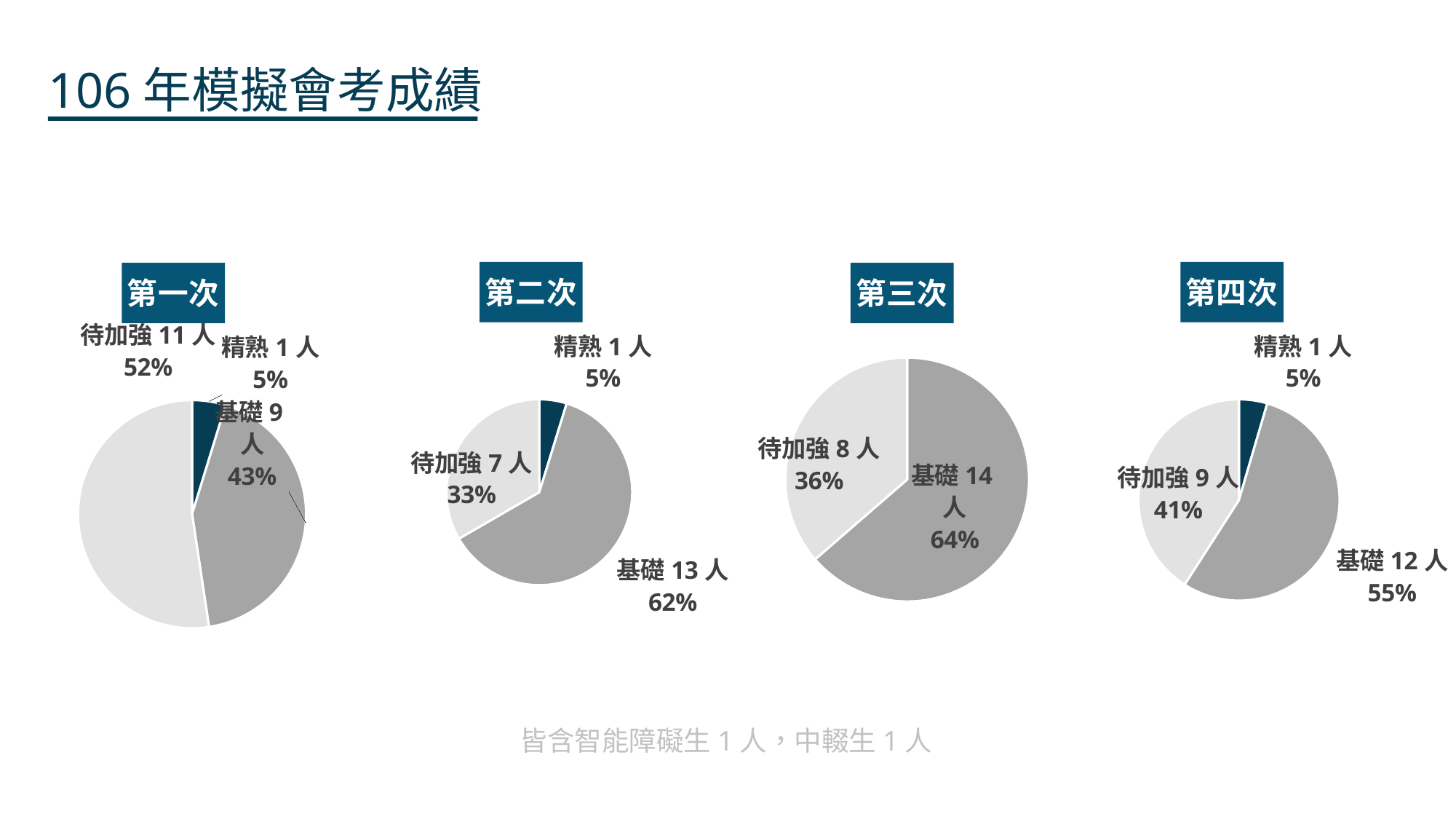
In the 第四次 pie chart, which is larger, 待加強 or 基礎? 基礎 In the 第二次 pie chart, what percentage is shown for 基礎? 62% In the 第三次 pie chart, what percentage is shown for 待加強? 36% In the 第一次 pie chart, which category has the largest slice? 待加強 In the 第二次 pie chart, which category has the smallest slice? 精熟 In the 第一次 pie chart, how many people are in the 待加強 category? 11 人 In the 第二次 pie chart, which category has the largest slice? 基礎 What kind of chart is used for 第三次? Pie chart In the 第三次 pie chart, how many people are in the 基礎 category? 14 人 How many pie charts are shown on the slide? 4 In the 第四次 pie chart, how many more people are in 基礎 than in 待加強? 3 人 In the 第一次 pie chart, what share of the pie does 基礎 take? 43%